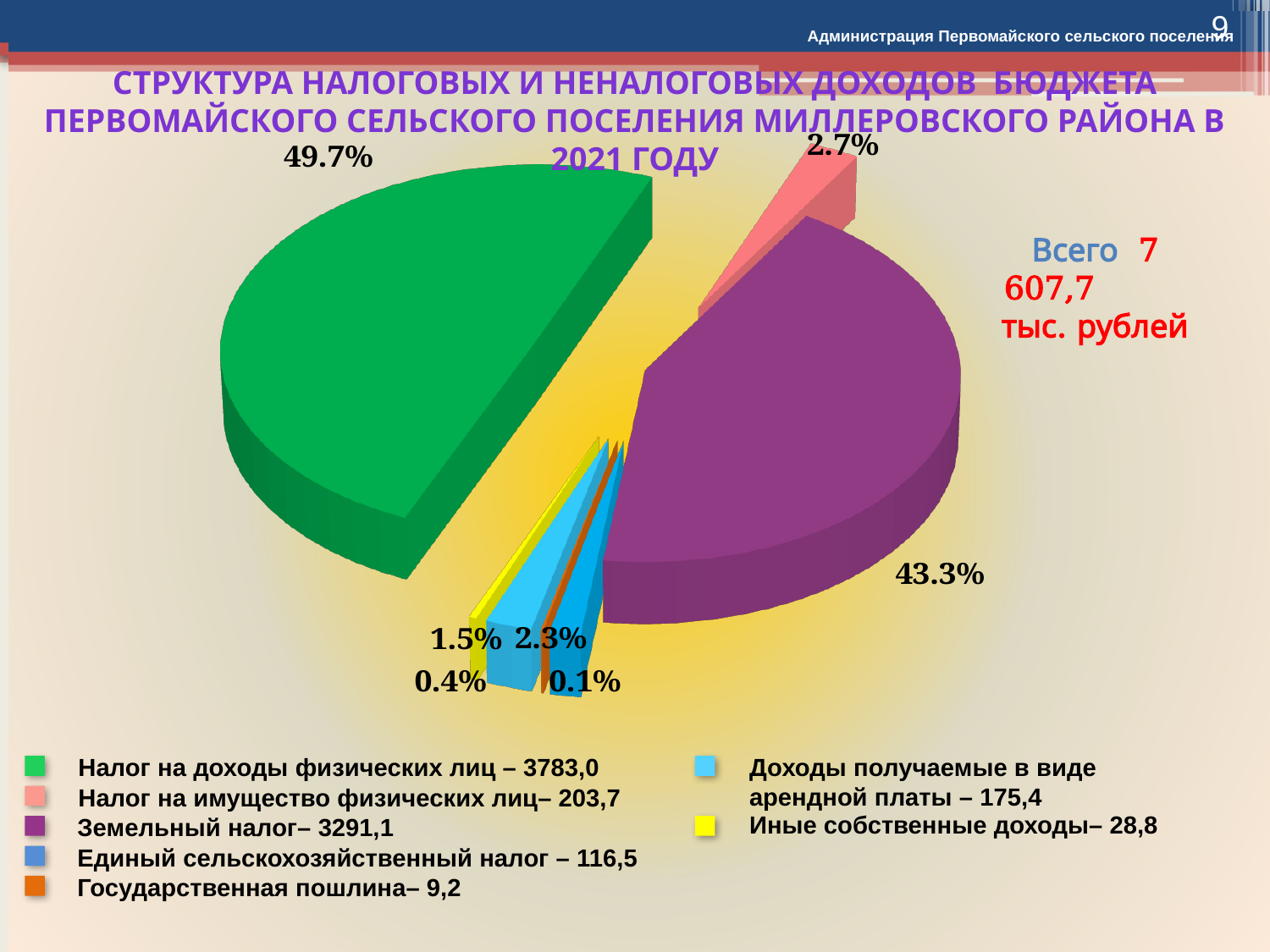
Which is larger: the slice for Земельный налог or the slice for Налог на доходы физических лиц? Налог на доходы физических лиц What total amount (Всего) is stated next to the pie chart? 7 607,7 тыс. рублей Which category has the largest slice of the pie? Налог на доходы физических лиц What share of the pie does Налог на имущество физических лиц have? 2.7% What share of the pie does Налог на доходы физических лиц have? 49.7% What value is given in the legend for Доходы получаемые в виде арендной платы? 175,4 What value is given in the legend for Земельный налог? 3291,1 Which category has the smallest slice of the pie? Государственная пошлина What is the difference in percentage points between the Налог на доходы физических лиц slice (49.7%) and the Земельный налог slice (43.3%)? 6.4 How many categories (slices) does the pie chart have? 7 What share of the pie does Земельный налог have? 43.3% What kind of chart is shown on the slide? pie chart